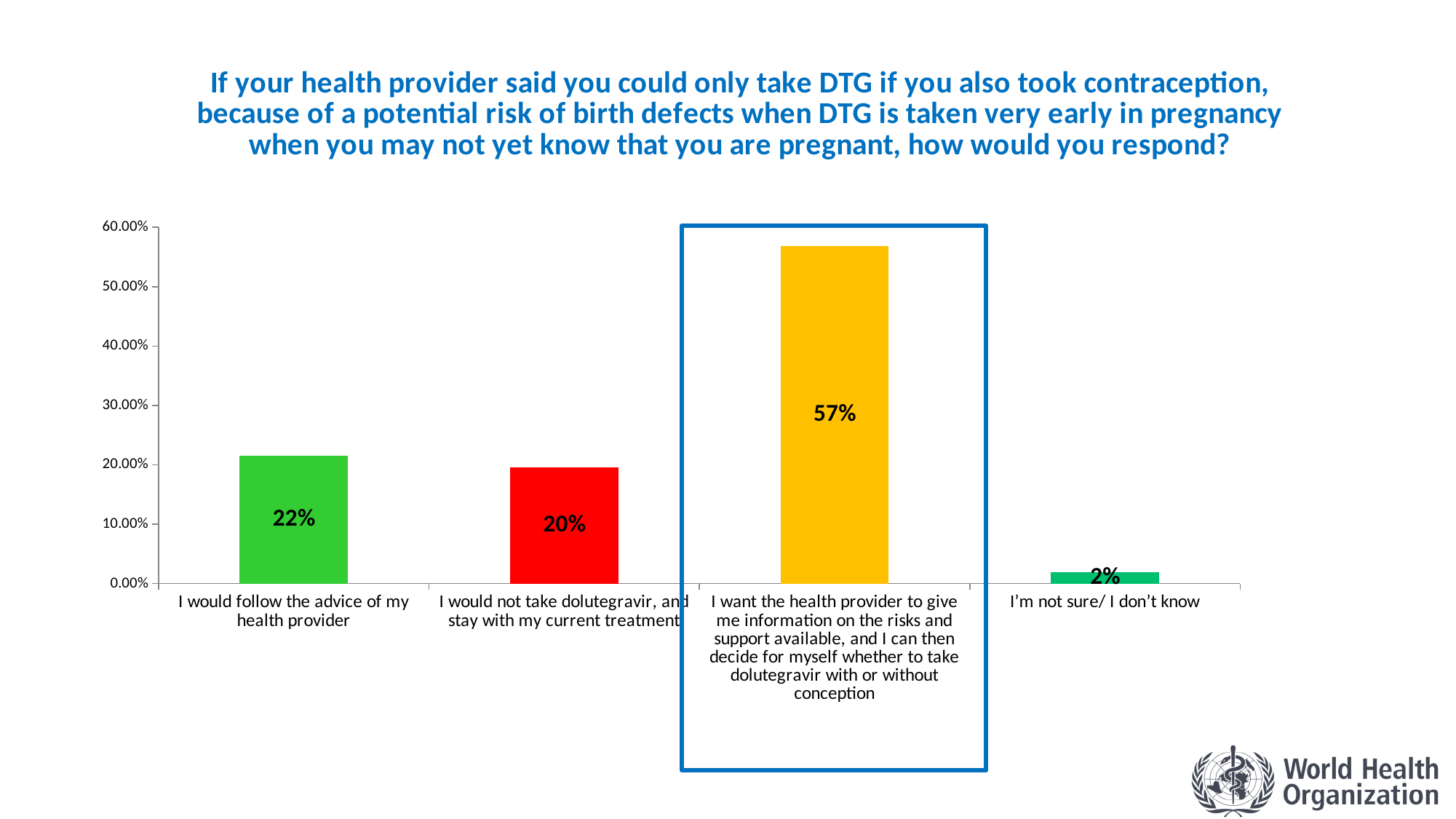
What percentage of respondents said they would follow the advice of their health provider? 22% How many response options are shown on the chart? 4 What percentage of respondents said they want the health provider to give them information on the risks and support available so they can decide for themselves? 57% What percentage of respondents answered 'I'm not sure/ I don't know'? 2% What percentage of respondents said they would not take dolutegravir and stay with their current treatment? 20% What colour is the bar for the response option highlighted with a blue box? Yellow What is the difference in percentage points between 'I would follow the advice of my health provider' and 'I would not take dolutegravir, and stay with my current treatment'? 2 percentage points Which is larger: the percentage for 'I would follow the advice of my health provider' or for 'I'm not sure/ I don't know'? I would follow the advice of my health provider Which response option has the lowest percentage? I'm not sure/ I don't know Which response option has the highest percentage? I want the health provider to give me information on the risks and support available, and I can then decide for myself whether to take dolutegravir with or without conception What is the difference in percentage points between the highest response and 'I'm not sure/ I don't know'? 55 percentage points What type of chart is shown on the slide? Bar chart